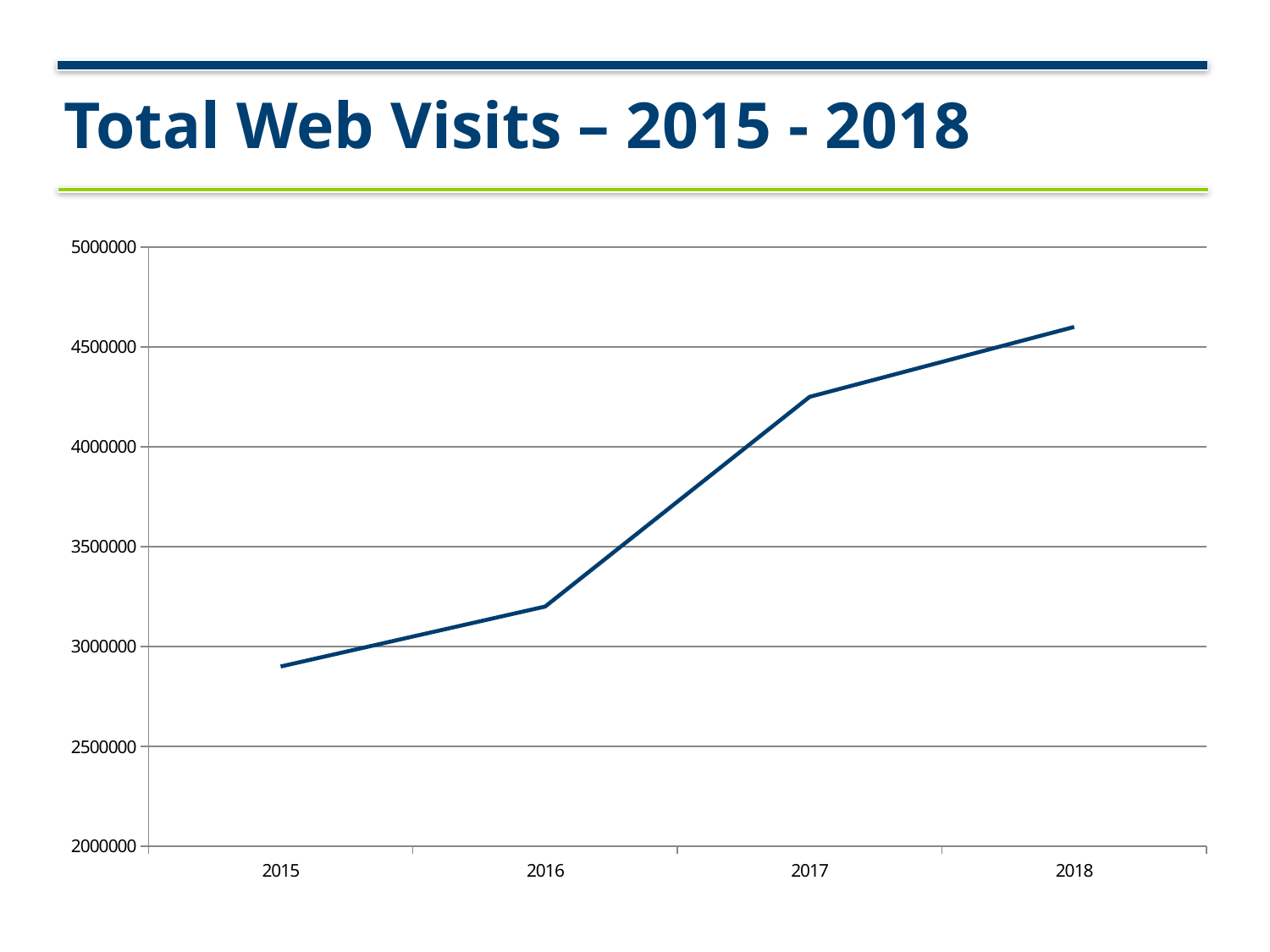
Is the value for 2015 greater or less than 3000000? less How many years are plotted on the x axis of the chart? 4 Is the value for 2017 greater or less than 4000000? greater Is the value for 2018 greater or less than 4500000? greater Which year has more web visits, 2016 or 2017? 2017 Which year has the lowest number of web visits? 2015 Which year has the highest number of web visits? 2018 What kind of chart is shown on the slide? line chart Do web visits rise or fall from 2015 to 2018? rise What is the title of the chart on the slide? Total Web Visits – 2015 - 2018